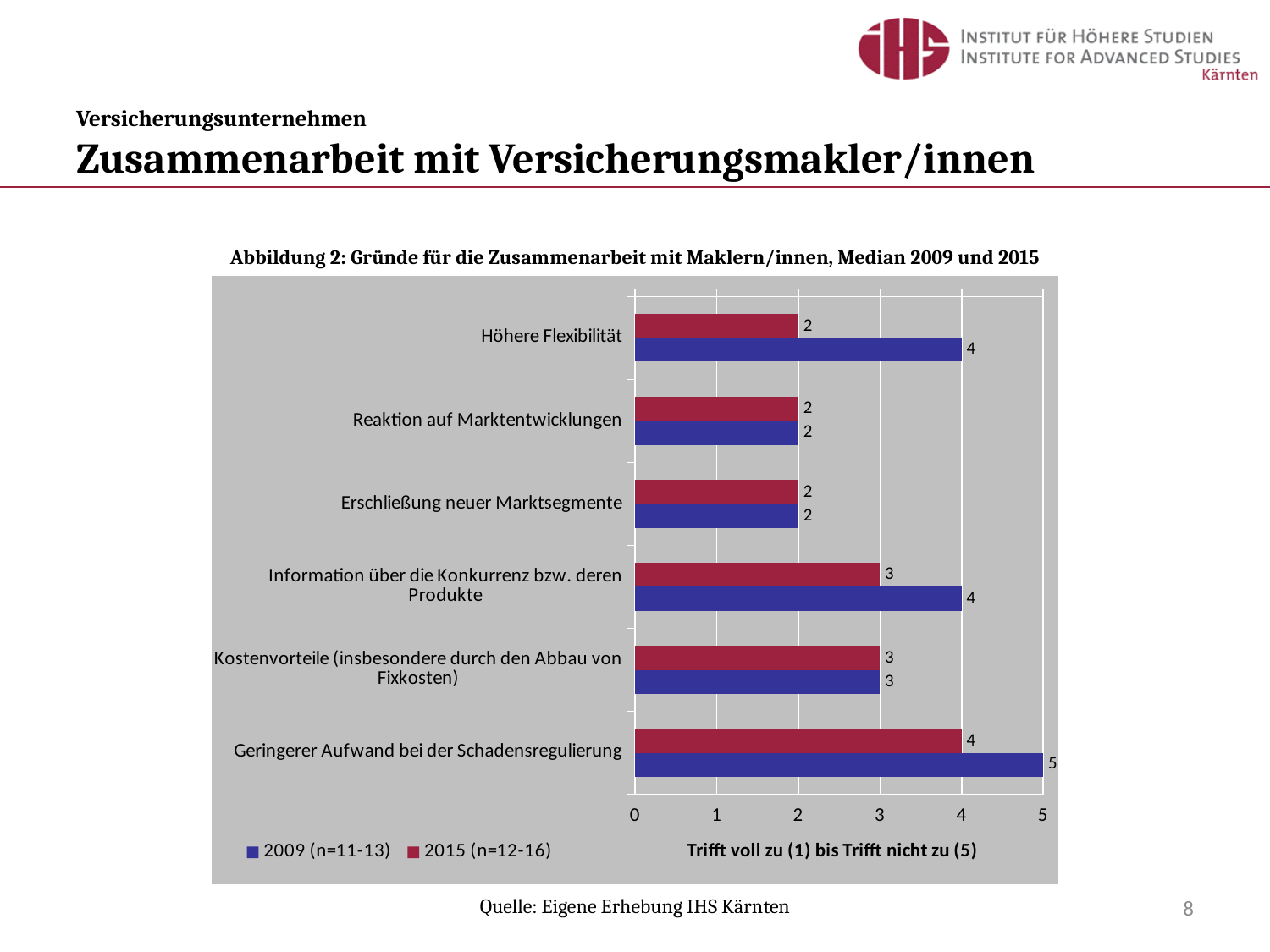
For Kostenvorteile (insbesondere durch den Abbau von Fixkosten), is the 2009 (n=11-13) value larger than, smaller than, or equal to the 2015 (n=12-16) value? equal What is the 2009 (n=11-13) value for Geringerer Aufwand bei der Schadensregulierung? 5 How many series does the legend list? 2 What is the 2009 (n=11-13) value for Höhere Flexibilität? 4 Which category has the highest 2009 (n=11-13) value? Geringerer Aufwand bei der Schadensregulierung What is the title of the chart? Abbildung 2: Gründe für die Zusammenarbeit mit Maklern/innen, Median 2009 und 2015 Which category has the highest 2015 (n=12-16) value? Geringerer Aufwand bei der Schadensregulierung How many categories are shown on the chart? 6 What is the difference between the 2009 (n=11-13) and 2015 (n=12-16) values for Höhere Flexibilität? 2 What is the 2015 (n=12-16) value for Information über die Konkurrenz bzw. deren Produkte? 3 What kind of chart is shown on the slide? bar chart What is the 2015 (n=12-16) value for Höhere Flexibilität? 2